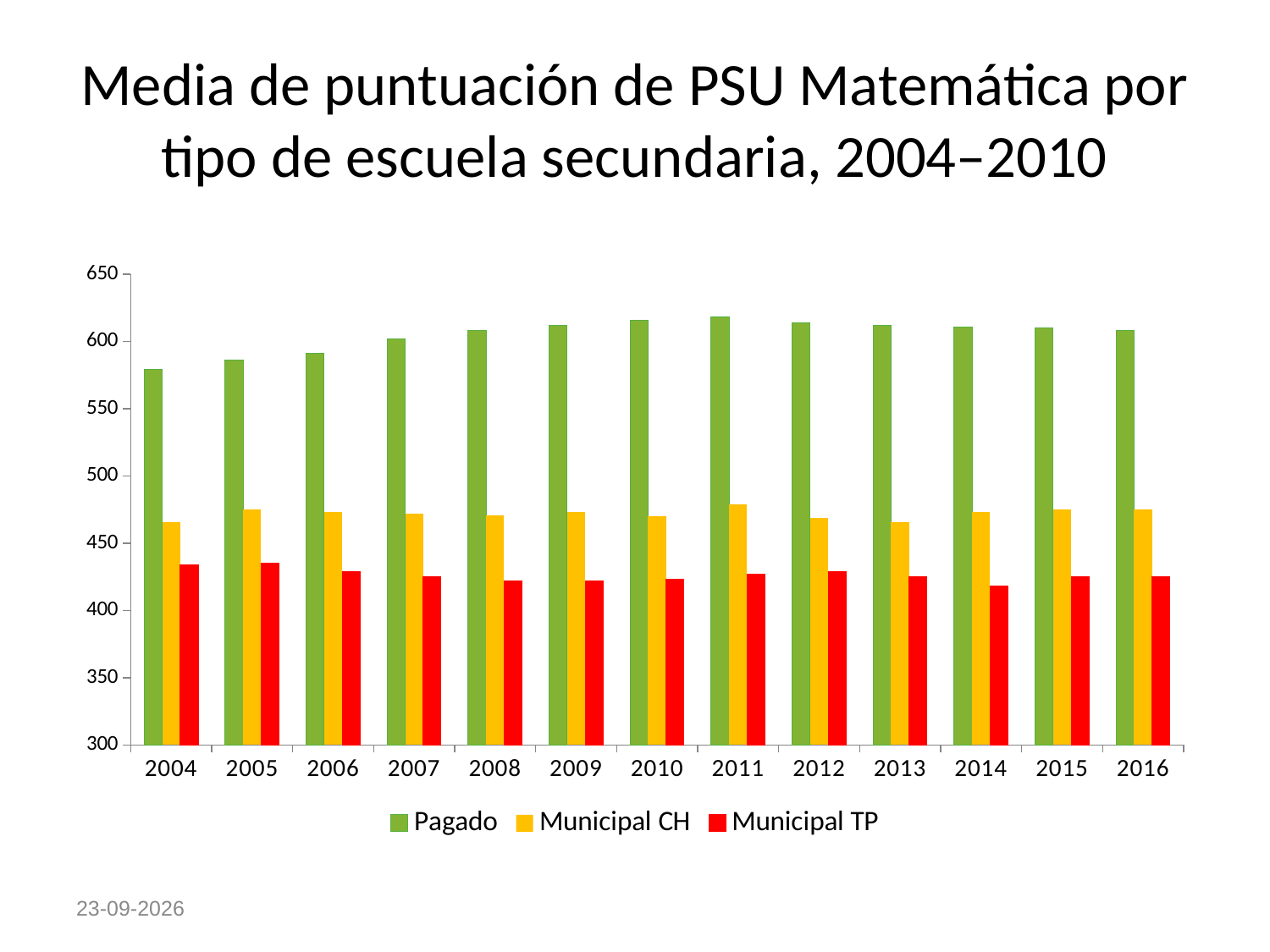
In which year is the Pagado value lowest? 2004 Which is larger in 2010, Municipal CH or Municipal TP? Municipal CH Is the value for Pagado in 2004 greater or less than 600? less What kind of chart is shown on the slide? bar chart Which series has the highest value in every year? Pagado Do the Pagado values rise or fall from 2004 to 2011? rise In which year is the Municipal TP value lowest? 2014 How many series does the legend list? 3 Is the value for Municipal CH in 2004 greater or less than 500? less How many years are shown on the x axis? 13 Is the value for Pagado in 2011 greater or less than 600? greater